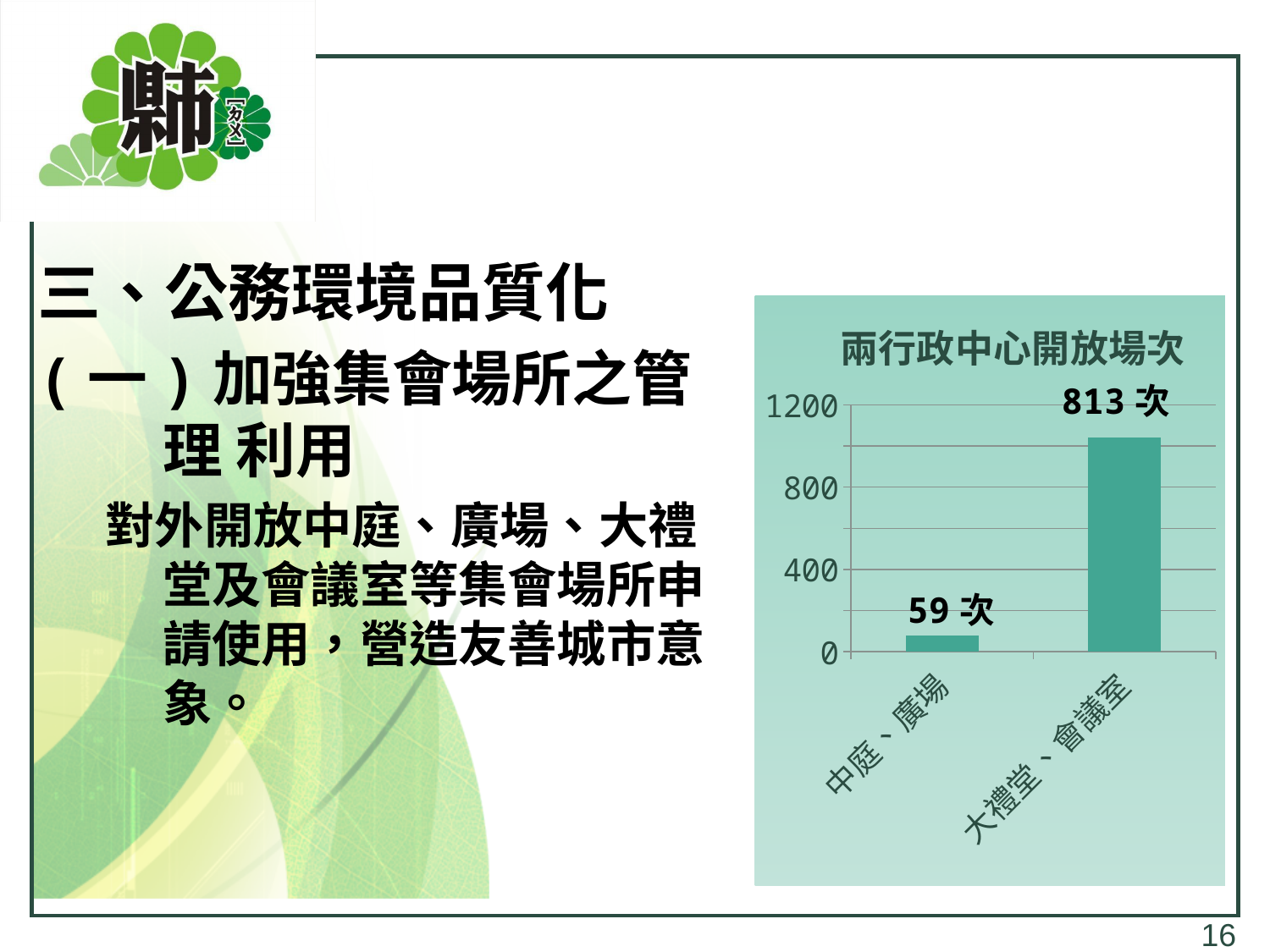
What is the highest value labelled on the vertical axis of the chart? 1200 Which is larger, the value for 中庭、廣場 or the value for 大禮堂、會議室? 大禮堂、會議室 What is the value shown for 大禮堂、會議室 in the chart? 813 次 What is the value shown for 中庭、廣場 in the chart? 59 次 Is the value for 大禮堂、會議室 greater or less than 400? greater What kind of chart is shown on the slide? bar chart What is the title of the chart? 兩行政中心開放場次 What is the difference between the values for 大禮堂、會議室 and 中庭、廣場? 754 次 Which category has the highest value in the chart? 大禮堂、會議室 How many categories are shown in the chart? 2 Is the value for 中庭、廣場 greater or less than 400? less Which category has the lowest value in the chart? 中庭、廣場